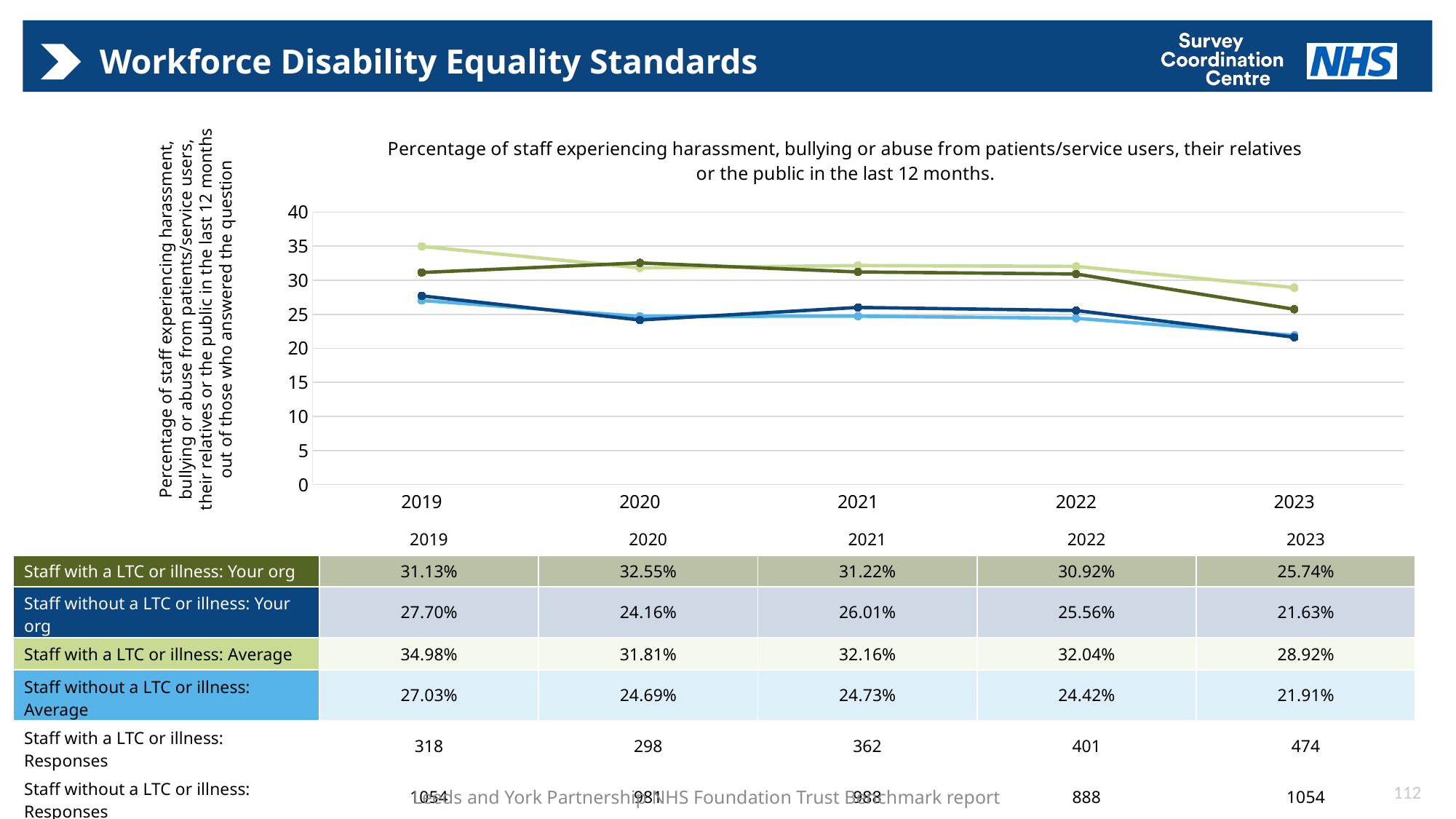
How many data series are plotted on the chart? 4 In which year is the value for Staff with a LTC or illness: Average highest? 2019 In which year is the value for Staff without a LTC or illness: Your org lowest? 2023 Is the 2019 value for Staff with a LTC or illness: Average greater or less than 30? greater Does the value for Staff with a LTC or illness: Average rise or fall from 2022 to 2023? fall In 2021, which is larger: Staff with a LTC or illness: Your org or Staff with a LTC or illness: Average? Staff with a LTC or illness: Average What kind of chart is shown on the slide? line chart How many years are shown on the x axis of the chart? 5 What is the value for Staff with a LTC or illness: Average in 2021? 32.16% What is the difference between the 2019 and 2023 values for Staff with a LTC or illness: Your org? 5.39 percentage points What is the value for Staff with a LTC or illness: Your org in 2020? 32.55% What is the value for Staff without a LTC or illness: Average in 2023? 21.91%